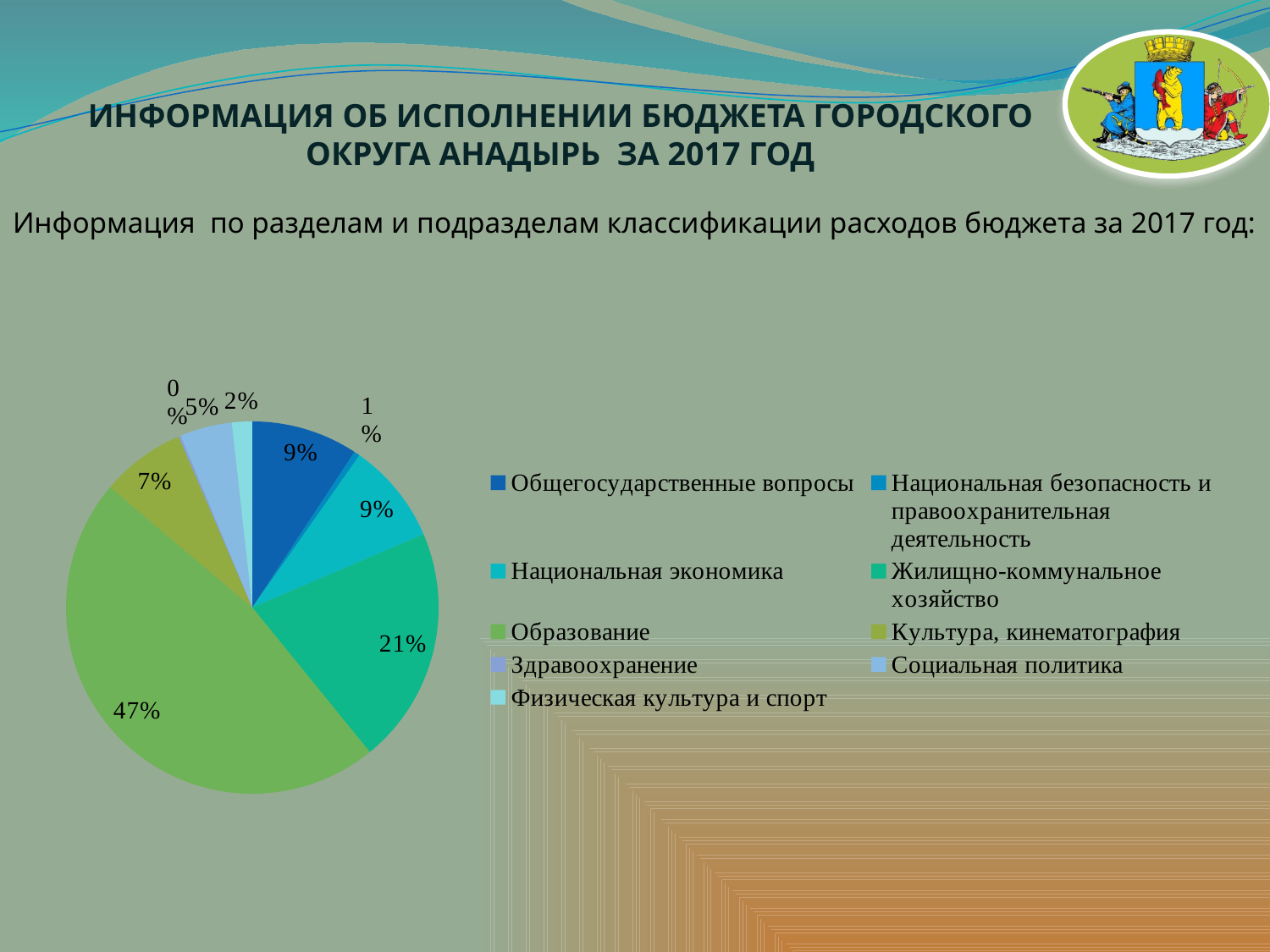
What share of the pie does Социальная политика have? 5% Which is larger: the share for Культура, кинематография or the share for Социальная политика? Культура, кинематография What is the difference in percentage points between Образование and Жилищно-коммунальное хозяйство? 26 What type of chart is shown on the slide? Pie chart What share of the pie does Физическая культура и спорт have? 2% What share of the pie does Здравоохранение have? 0% Which category has the largest share of the pie? Образование What share of the pie does Жилищно-коммунальное хозяйство have? 21% How many categories does the legend list? 9 What share of the pie does Культура, кинематография have? 7% What share of the pie does Образование have? 47% Which category has the smallest share of the pie? Здравоохранение